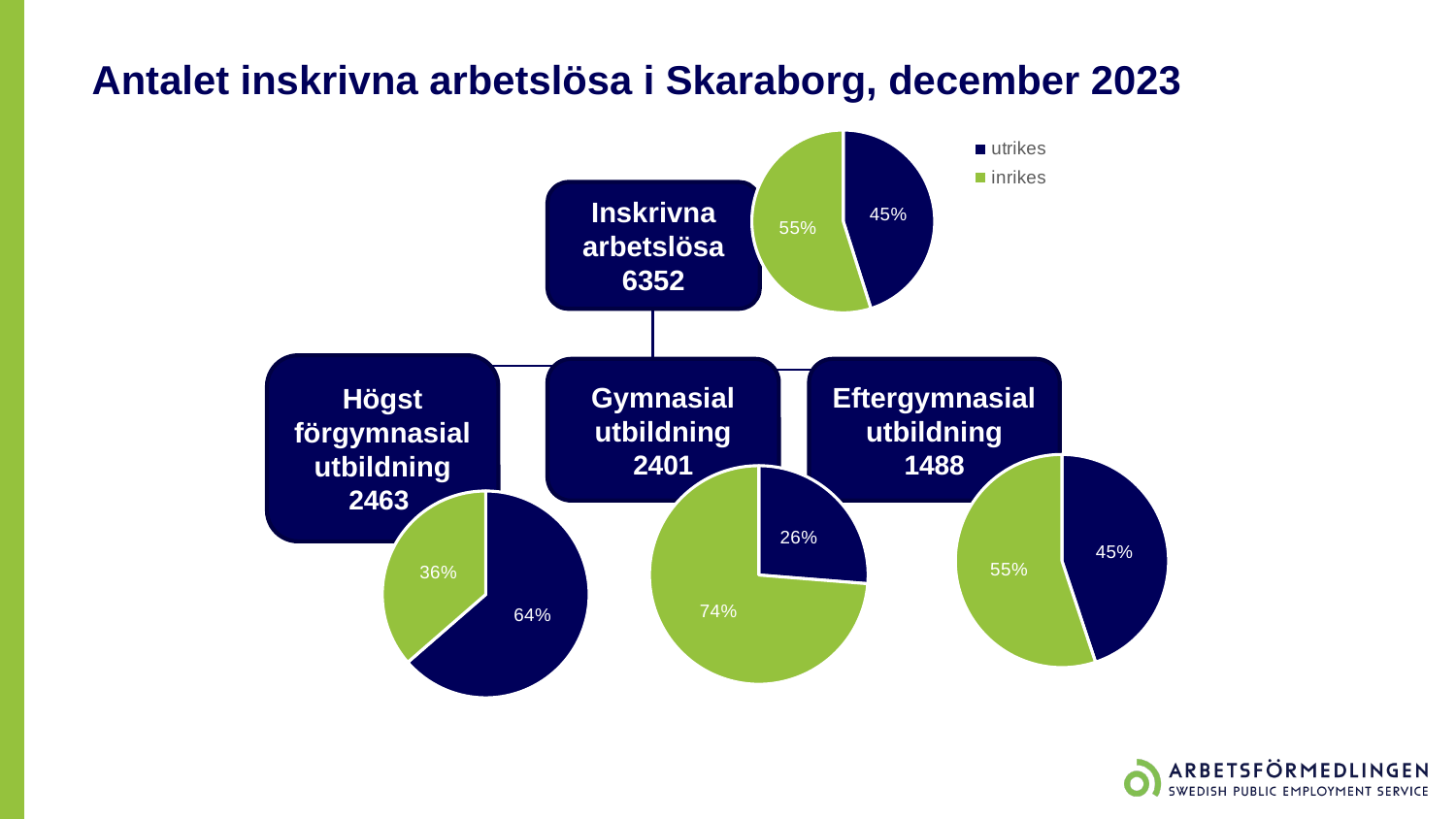
In the pie chart below 'Högst förgymnasial utbildning', what share is inrikes? 36% In the pie chart below 'Högst förgymnasial utbildning', which slice is larger, utrikes or inrikes? utrikes In the pie chart below 'Eftergymnasial utbildning', what share is inrikes? 55% In the pie chart below 'Högst förgymnasial utbildning', what is the difference in percentage points between the utrikes and inrikes shares? 28 percentage points How many entries does the legend at the top right list? 2 In the pie chart below 'Gymnasial utbildning', what share is utrikes? 26% What kind of charts are shown on the slide? Pie charts In the pie chart below 'Gymnasial utbildning', which slice is larger, utrikes or inrikes? inrikes